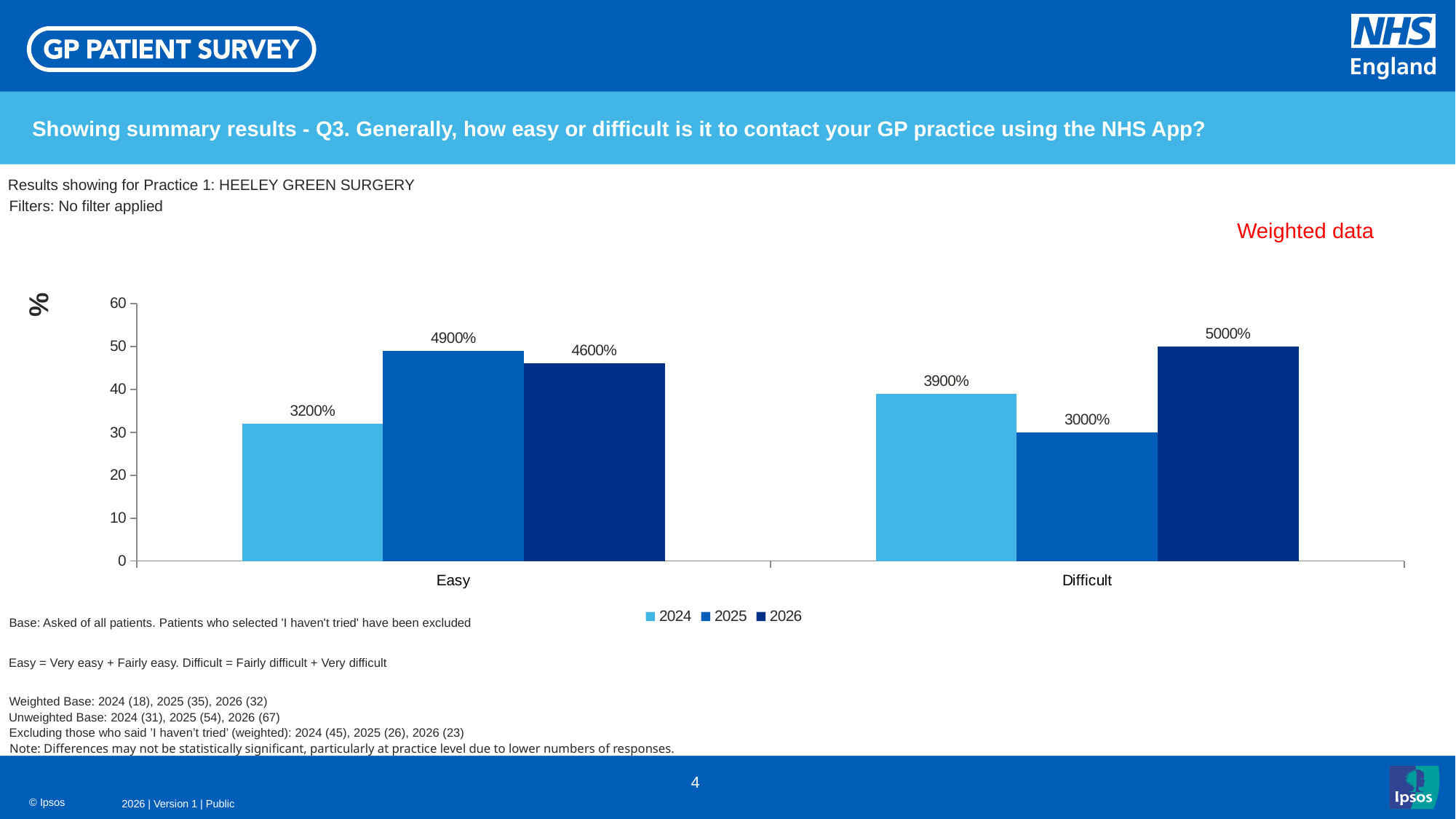
What is the data label for 2025 in the Difficult category? 3000% How many series does the legend list? 3 How many categories are shown on the x axis? 2 Which is larger in the Difficult category: the 2024 bar or the 2025 bar? 2024 Which year has the lowest bar in the Difficult category? 2025 What type of chart is shown on the slide? bar chart What is the label on the vertical axis? % What is the data label for 2026 in the Difficult category? 5000% Is the 2024 bar in the Easy category above or below the 40 gridline on the axis? below Which year has the highest bar in the Easy category? 2025 What is the data label for 2026 in the Easy category? 4600% What is the data label for 2024 in the Easy category? 3200%